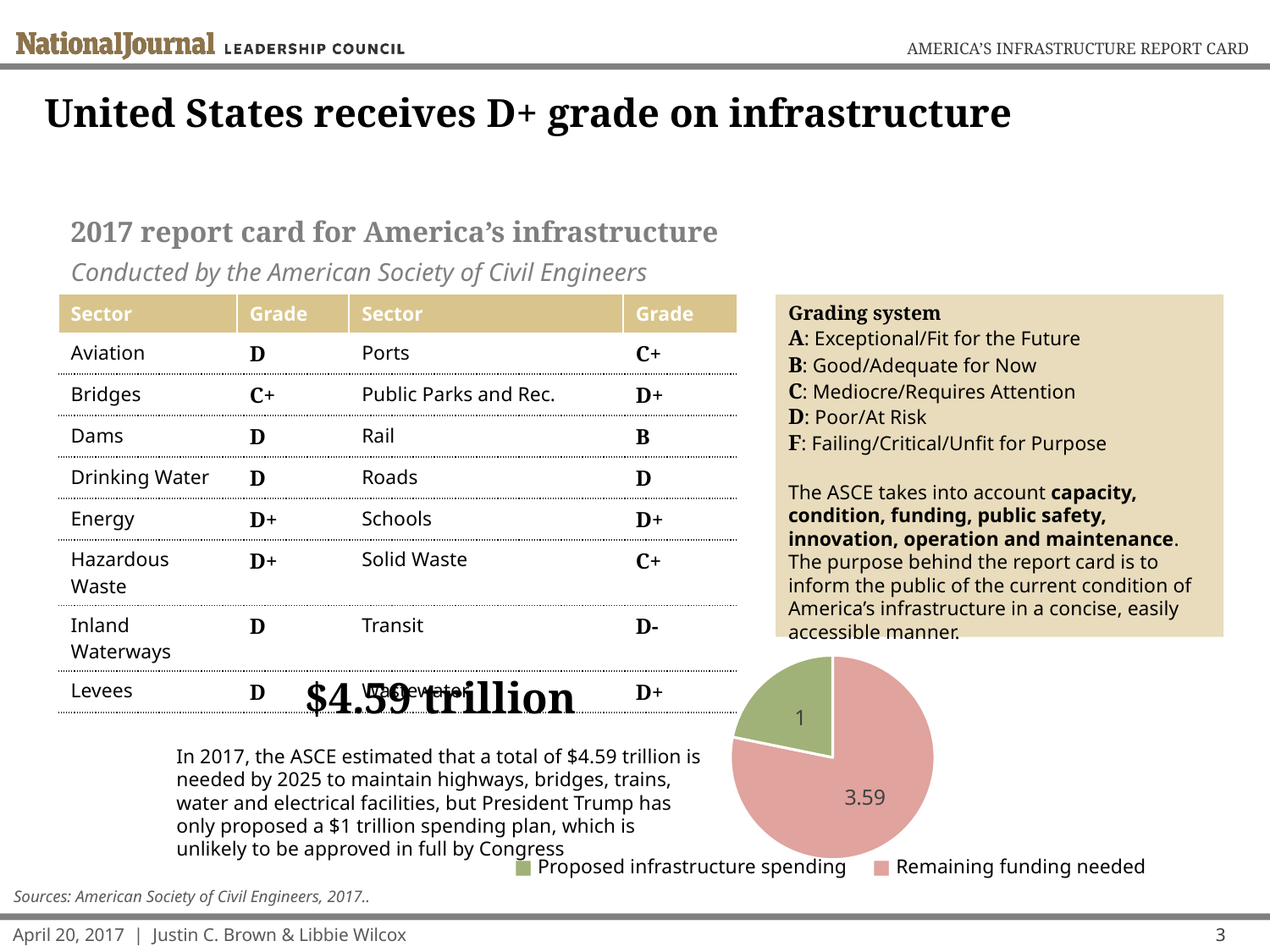
In the pie chart, what is the value for Remaining funding needed? 3.59 How many slices does the pie chart have? 2 Which slice of the pie chart is the smallest? Proposed infrastructure spending How many entries does the pie chart's legend list? 2 In the pie chart, what is the value for Proposed infrastructure spending? 1 What is the total of the two values shown in the pie chart? 4.59 In the pie chart, which is larger: Proposed infrastructure spending or Remaining funding needed? Remaining funding needed What kind of chart is shown at the bottom right of the slide? pie chart What colour is the Proposed infrastructure spending slice in the pie chart? green Which slice of the pie chart is the largest? Remaining funding needed What colour is the Remaining funding needed slice in the pie chart? pink In the pie chart, what is the difference between Remaining funding needed and Proposed infrastructure spending? 2.59